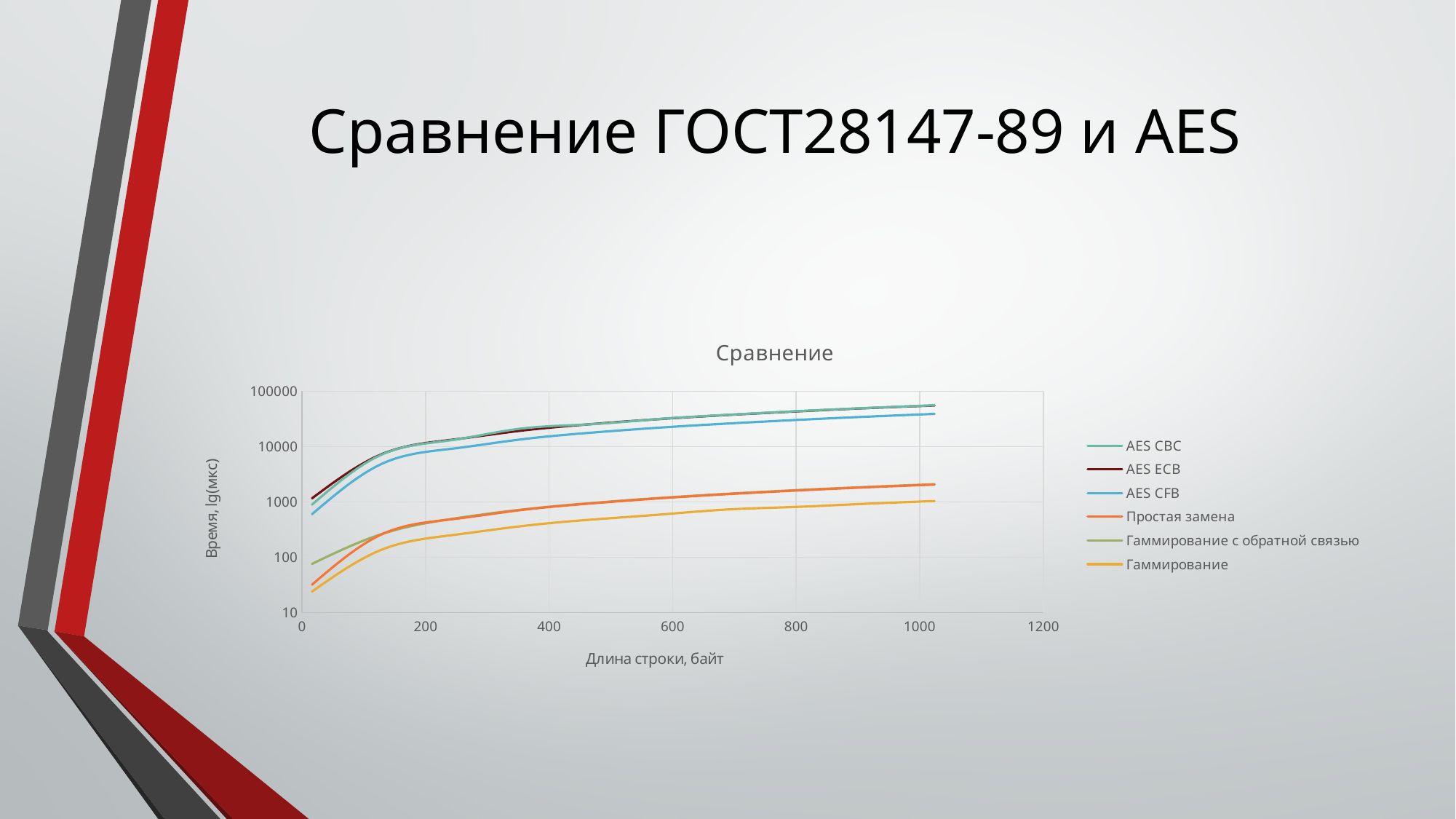
What is the label of the vertical axis of the chart? Время, lg(мкс) Do the values of the AES CFB series rise or fall as the string length increases along the x axis? rise At a string length of 600, which series has the larger value: AES CFB or Простая замена? AES CFB What kind of chart is shown on the slide? line chart Which series has the lowest value at a string length of 1000? Гаммирование What is the title of the chart? Сравнение At a string length of 200, which series has the larger value: Простая замена or Гаммирование? Простая замена How many series does the legend of the chart list? 6 Is the value for AES CFB at a string length of 1000 greater or less than 10000? greater Do the values of the Гаммирование series rise or fall along the x axis? rise Is the value for Простая замена at a string length of 1000 greater or less than 1000? greater Is the value for Гаммирование at a string length of 1000 greater or less than 10000? less